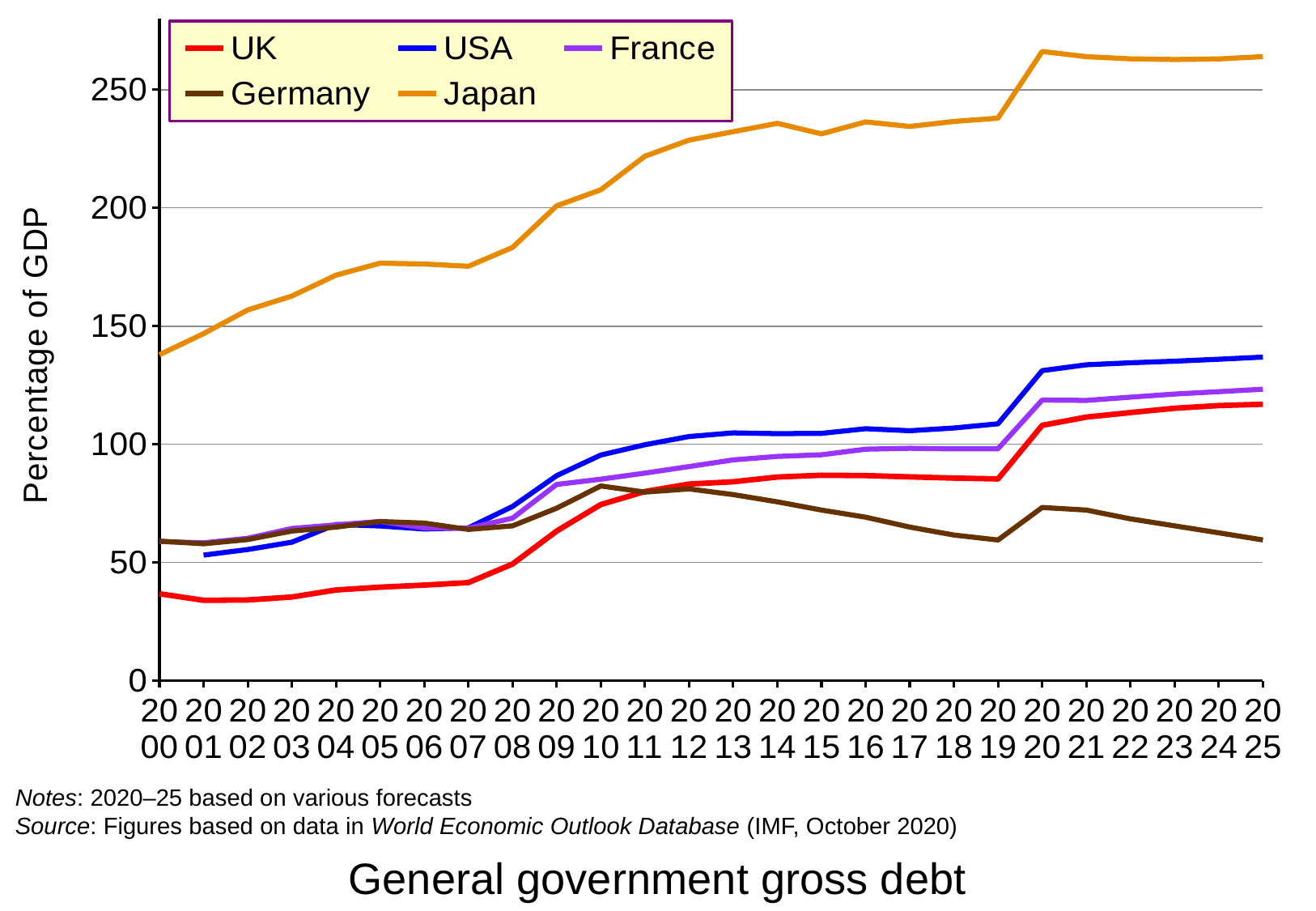
What is the title of the chart? General government gross debt Which country has the highest general government gross debt in 2025? Japan Is the value for the UK in 2000 greater or less than 50? less Which country has the lowest general government gross debt in 2025? Germany Does the value for Germany rise or fall from 2010 to 2019? fall How many years are shown along the x axis? 26 In 2020, which is larger, the value for the USA or the value for the UK? USA How many series does the legend list? 5 Is the value for the USA in 2025 greater or less than 150? less Is the value for Japan in 2025 greater or less than 250? greater What kind of chart is shown on the slide? line chart Does the value for Japan generally rise or fall from 2000 to 2025? rise